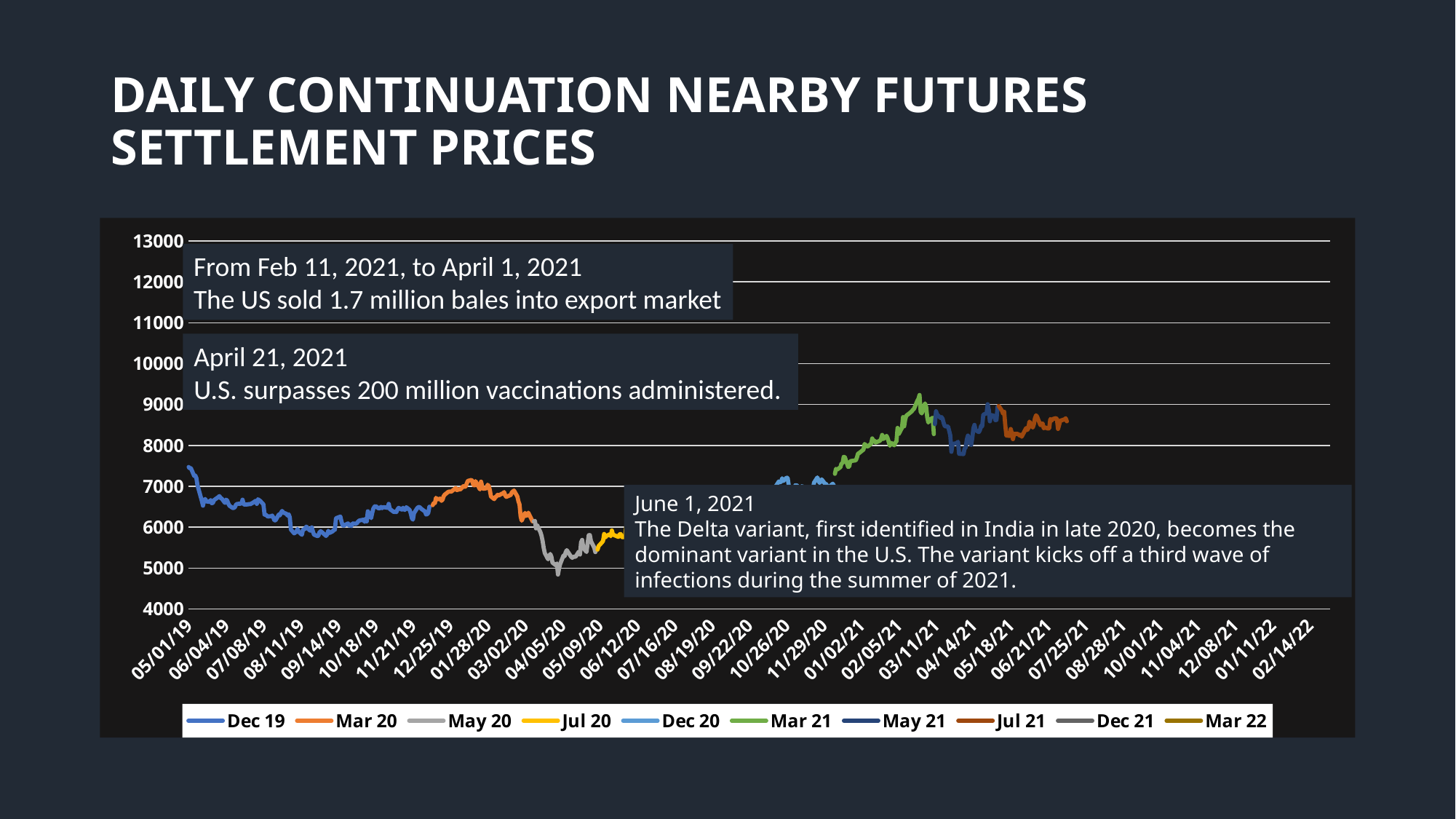
What is the title of the chart on the slide? Daily Continuation Nearby Futures Settlement Prices What colour is the Mar 21 series in the legend? green What kind of chart is shown on the slide? line chart Does the Mar 21 series generally rise or fall along the x axis? rise Is the value at the end of the plotted data (Jul 21 series) higher or lower than the value at the start (Dec 19 series)? higher Which series has higher values, Jul 21 or May 20? Jul 21 Which series reaches the highest value on the chart? Mar 21 How many series does the legend list? 10 Is the value of the Dec 19 series around 08/11/19 greater or less than 7000? less Is the value of the Dec 19 series at the start of the chart (05/01/19) greater or less than 7000? greater Are the values of the Jul 21 series greater or less than 8000? greater Which series reaches the lowest value on the chart? May 20